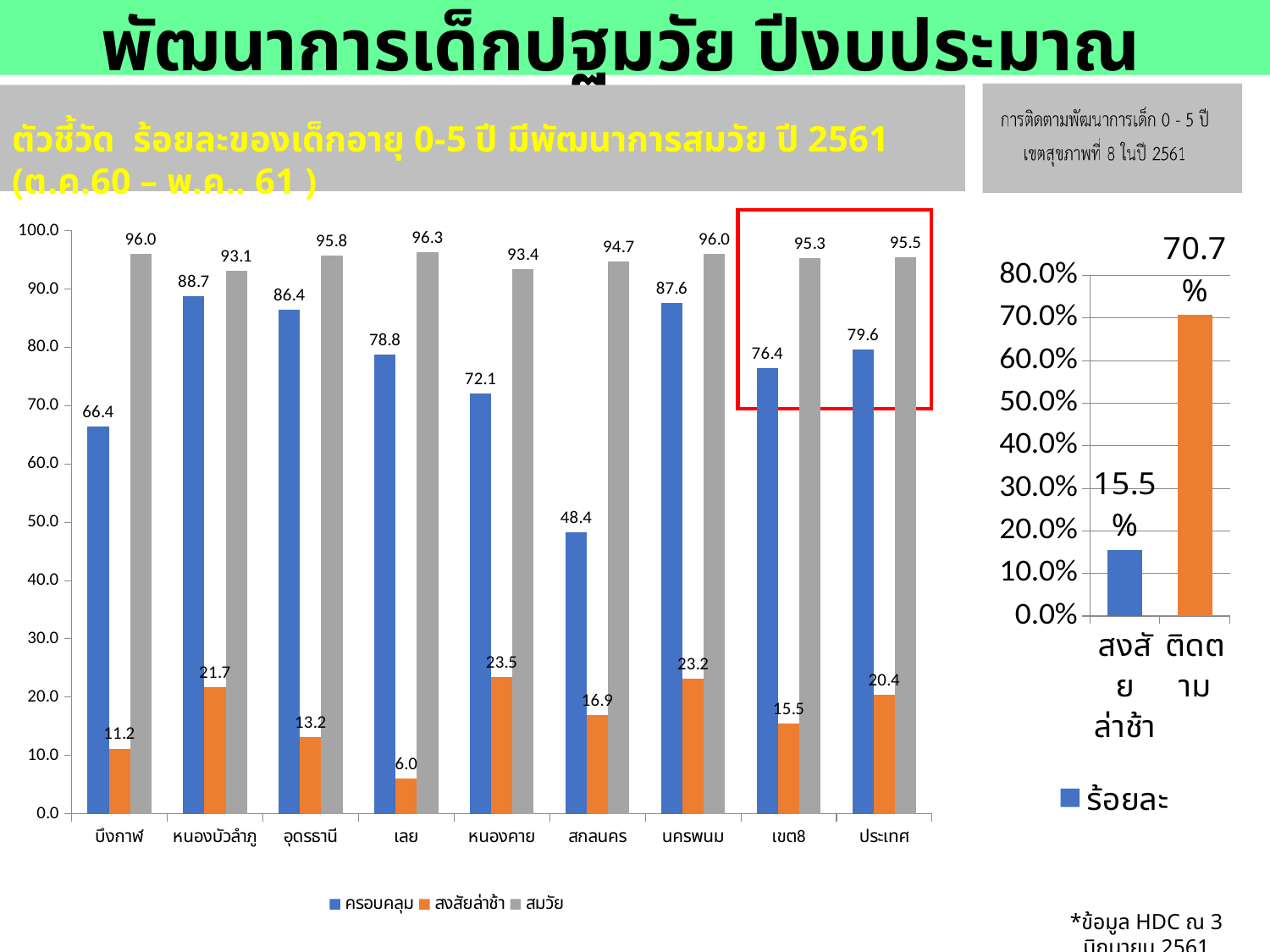
In the large bar chart on the left, which category has the highest สงสัยล่าช้า value? หนองคาย In the large bar chart on the left, what is the สงสัยล่าช้า value for เลย? 6.0 How many categories are shown on the x axis of the large bar chart on the left? 9 In the large bar chart on the left, which is larger, the ครอบคลุม value for เขต8 or for ประเทศ? ประเทศ What is the legend entry of the small bar chart on the right? ร้อยละ In the small bar chart on the right, what is the value for ติดตาม? 70.7% What kind of chart is the small chart on the right of the slide? bar chart In the large bar chart on the left, what is the สมวัย value for เขต8? 95.3 In the large bar chart on the left, what is the ครอบคลุม value for บึงกาฬ? 66.4 How many series does the legend of the large bar chart on the left list? 3 In the large bar chart on the left, what is the difference between the ครอบคลุม values for หนองบัวลำภู and เขต8? 12.3 In the large bar chart on the left, which category has the lowest ครอบคลุม value? สกลนคร